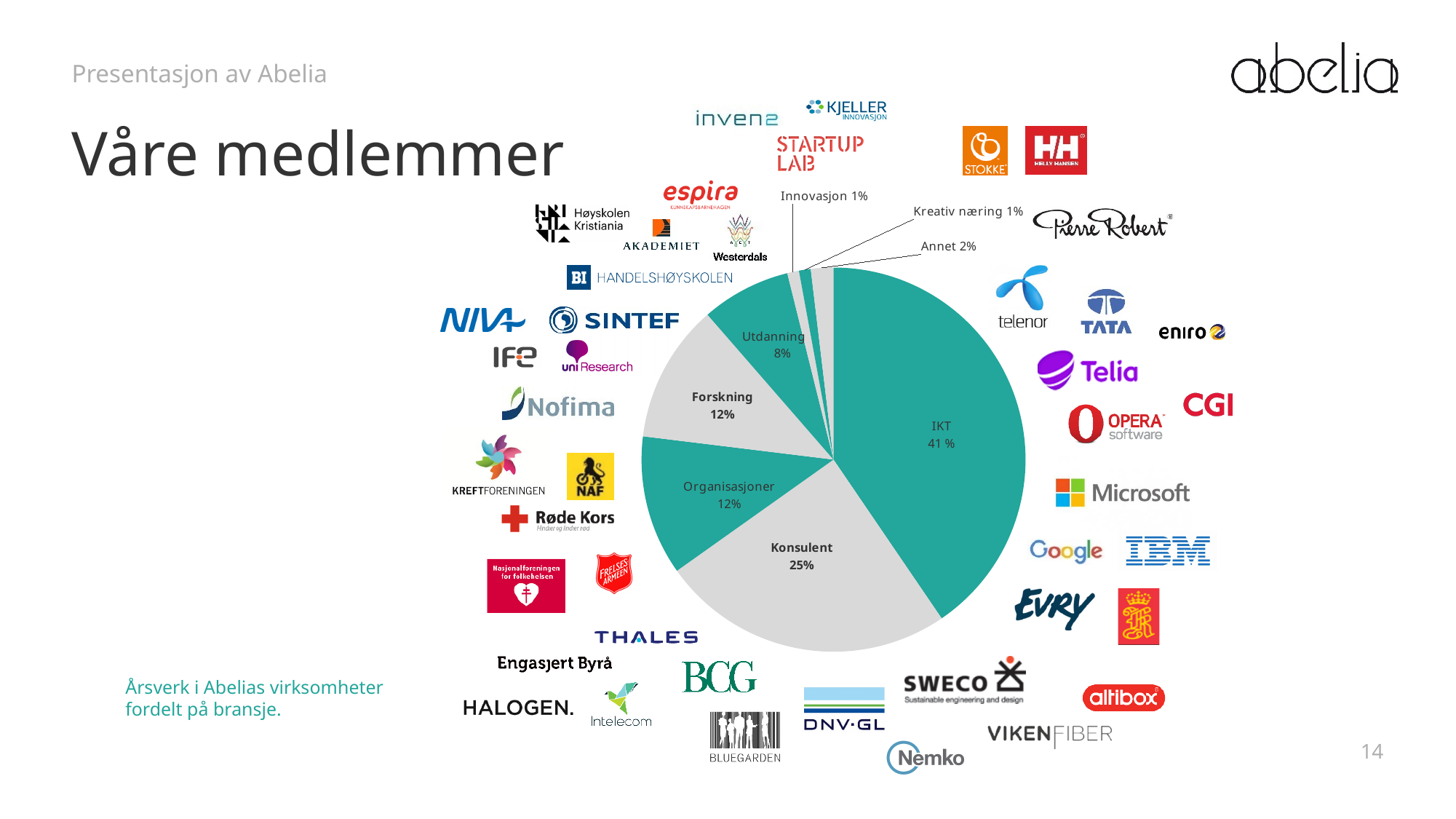
How many slices does the pie chart have? 8 Which is larger, the slice for Konsulent or the slice for Forskning? Konsulent What percentage is shown for Konsulent in the pie chart? 25% According to the caption, what does the pie chart show? Årsverk i Abelias virksomheter fordelt på bransje What share of the pie chart does IKT account for? 41 % What is the difference in percentage points between Utdanning and Annet? 6 What percentage is shown for Annet? 2% What percentage is shown for Organisasjoner? 12% What kind of chart is shown on the slide? Pie chart Which category has the largest slice of the pie chart? IKT What percentage is shown for Utdanning? 8% What is the difference in percentage points between IKT and Konsulent? 16